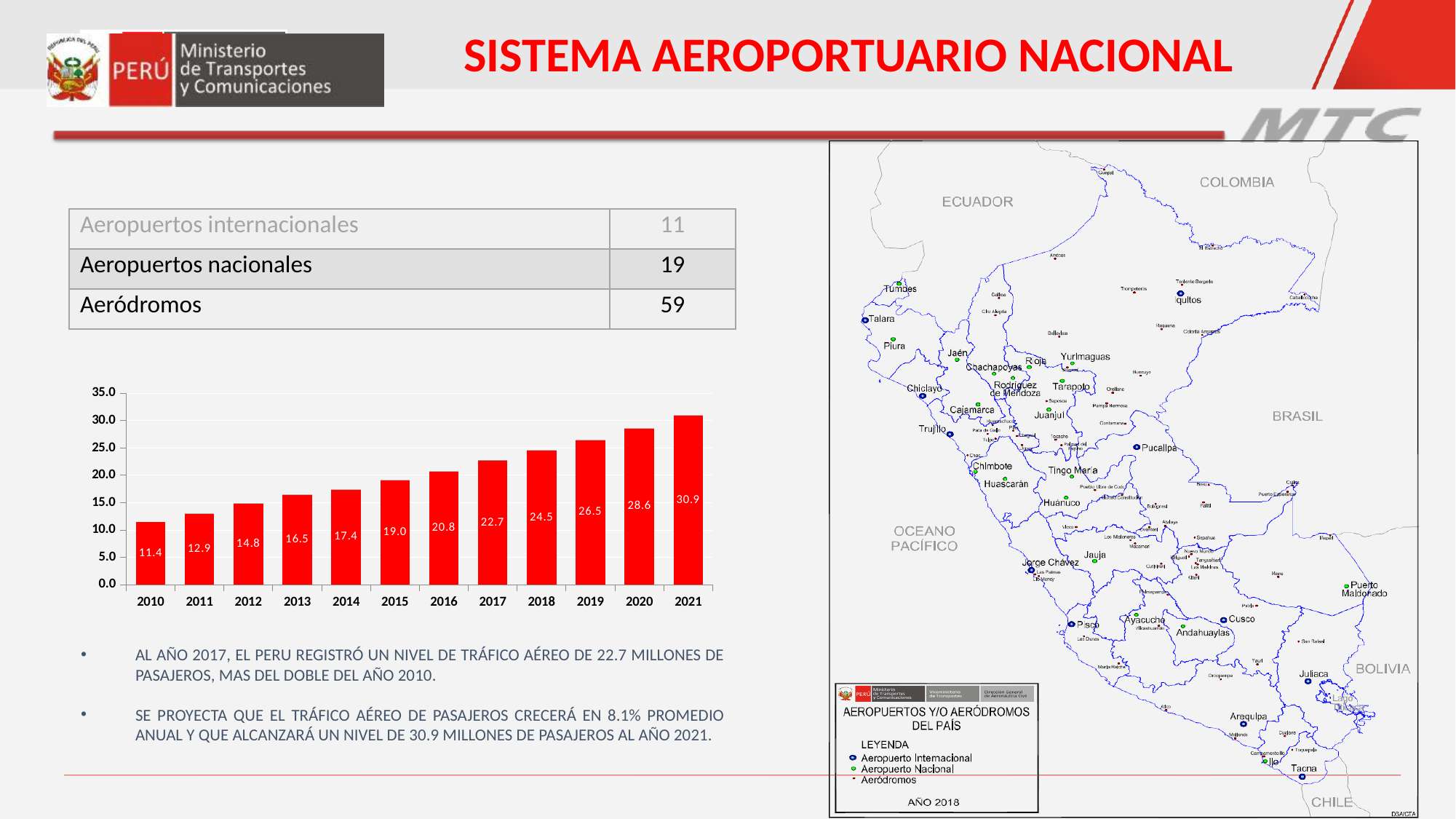
Do the values in the bar chart rise or fall from 2010 to 2021? rise How many years are shown on the x axis of the bar chart? 12 What kind of chart is used to show the values from 2010 to 2021? bar chart Which year has the lowest value in the bar chart? 2010 What is the value shown for 2017 in the bar chart? 22.7 What is the difference between the values for 2021 and 2010 in the bar chart? 19.5 What is the value shown for 2010 in the bar chart? 11.4 Is the value for 2018 in the bar chart greater or less than 25.0? less Which is larger in the bar chart, the value for 2015 or the value for 2013? 2015 Which year has the highest value in the bar chart? 2021 What is the difference between the values for 2020 and 2019 in the bar chart? 2.1 What is the value shown for 2021 in the bar chart? 30.9